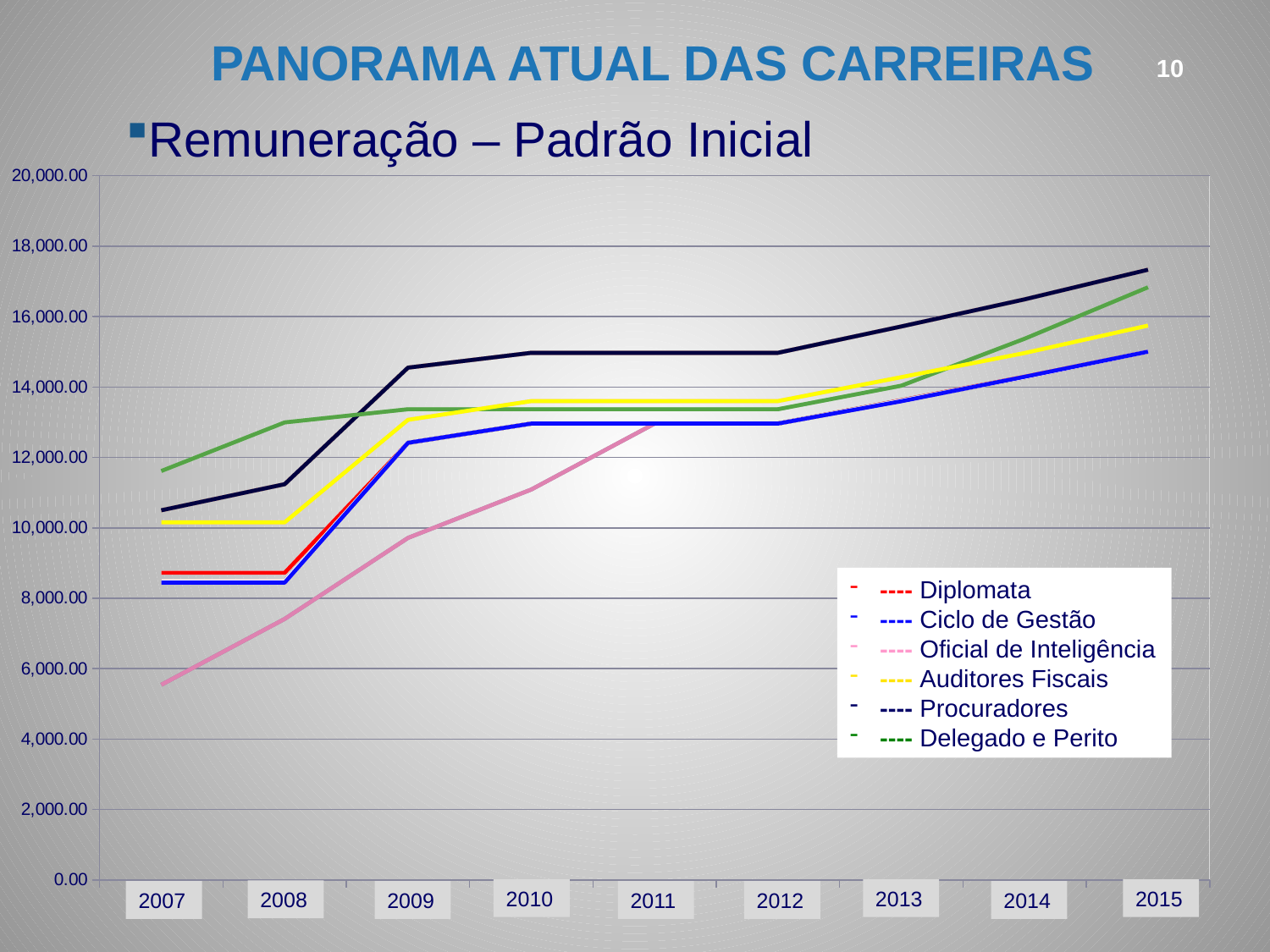
How many years are shown along the x axis? 9 Is the value for Procuradores in 2015 greater or less than 16,000.00? greater What kind of chart is shown on the slide? Line chart In 2008, which is higher: Auditores Fiscais or Ciclo de Gestão? Auditores Fiscais Is the value for Delegado e Perito in 2007 greater or less than 10,000.00? greater In 2007, which is higher: Delegado e Perito or Procuradores? Delegado e Perito Which series has the highest value in 2015? Procuradores How many series does the legend list? 6 Is the value for Ciclo de Gestão in 2015 greater or less than 14,000.00? greater Does the Procuradores line rise or fall from 2007 to 2015? Rise Which series has the lowest value in 2007? Oficial de Inteligência